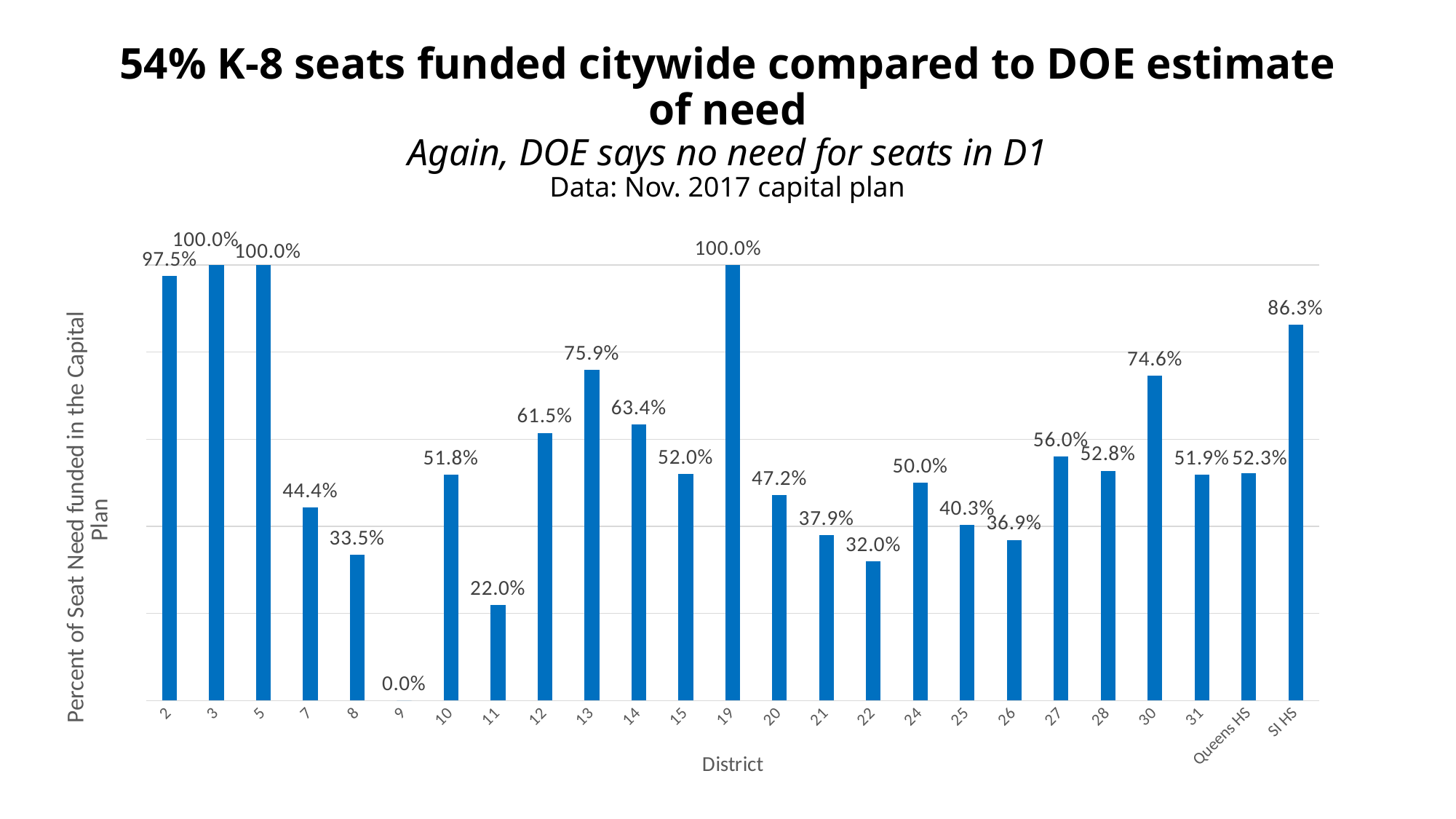
What is the label of the x axis? District What is the value for district 11? 22.0% How many categories are shown on the x axis? 25 What is the difference between the values for district 2 and district 7? 53.1% What is the value for SI HS? 86.3% Which district has the lowest percent of seat need funded? 9 Which is larger, the value for district 8 or the value for district 25? district 25 What is the difference between the values for district 30 and district 22? 42.6% What kind of chart is shown on the slide? bar chart What is the value for Queens HS? 52.3% Which is larger, the value for district 12 or the value for district 20? district 12 What is the value for district 13? 75.9%